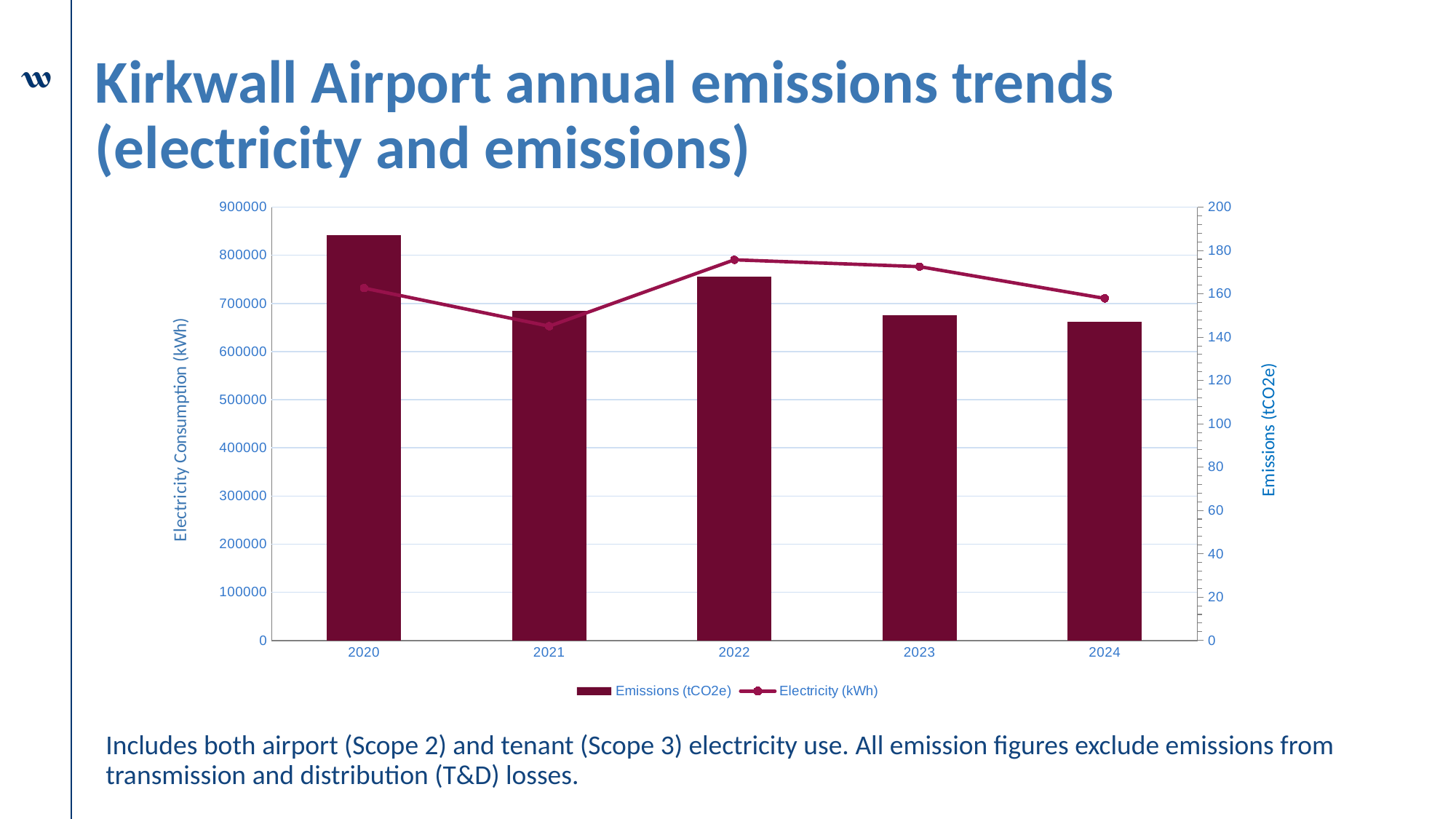
Which bar is taller, 2022 or 2023? 2022 How many years are shown along the x axis? 5 In which year does the line reach its lowest point? 2021 Is the bar for 2021 greater or less than 700000 on the left axis? less How many series does the legend list? 2 Do the bars rise or fall from 2022 to 2024? fall In which year does the line reach its highest point? 2022 Is the line value for 2023 greater or less than 160 on the right axis? greater Is the bar for 2020 greater or less than 800000 on the left axis? greater What kind of chart is shown on the slide? A combined bar and line chart What is the label on the right-hand vertical axis? Emissions (tCO2e) Which year has the tallest bar? 2020